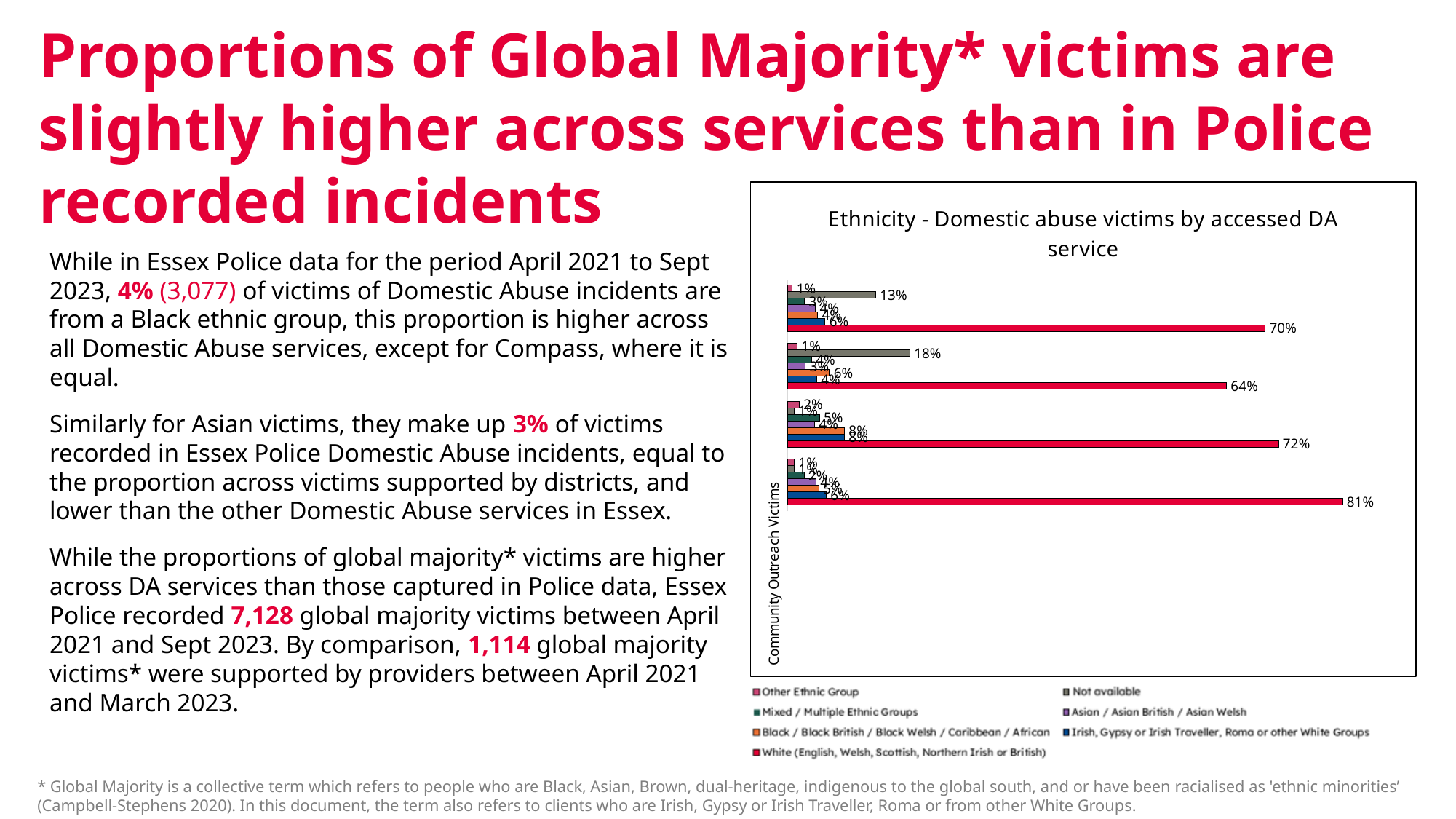
Is the White series value for Community Outreach Victims greater or less than 70%? greater What is the value for Not available in the second group of bars from the top? 18% What is the title of the chart? Ethnicity - Domestic abuse victims by accessed DA service What is the value for Not available in the topmost group of bars? 13% What is the lowest value shown for the White (English, Welsh, Scottish, Northern Irish or British) series across all groups? 64% What is the highest value shown for the White (English, Welsh, Scottish, Northern Irish or British) series across all groups? 81% What type of chart is shown on the slide? bar chart How many groups of bars (service categories) are plotted in the chart? 4 Which is larger: the White series value in the topmost group (70%) or in the second group from the top (64%)? the topmost group (70%) How many series does the chart's legend list? 7 What is the value for White (English, Welsh, Scottish, Northern Irish or British) for Community Outreach Victims? 81% What is the difference between the highest and lowest White series values shown (81% and 64%)? 17%